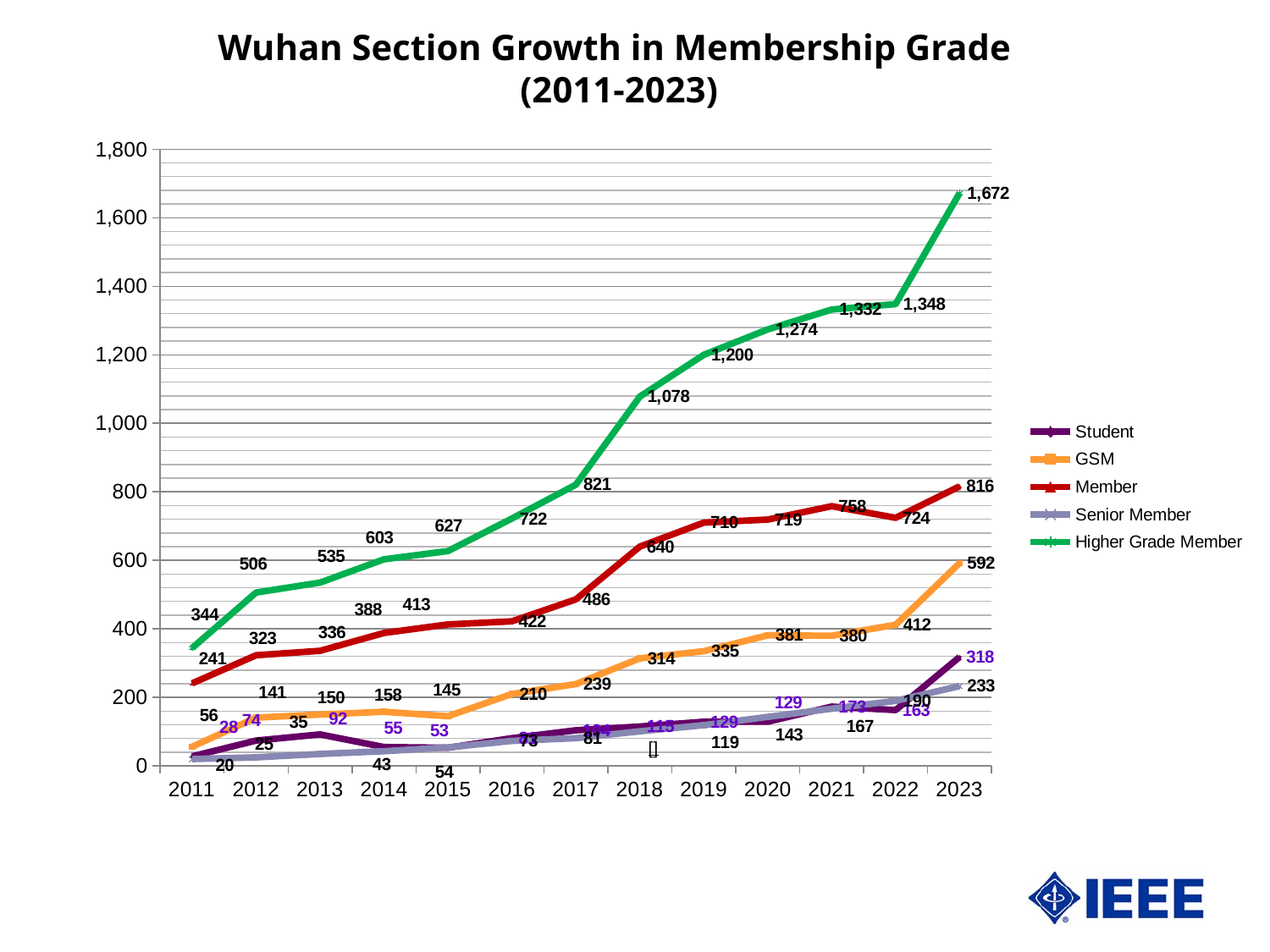
What is the value for GSM in 2023? 592 What is the value for Higher Grade Member in 2023? 1,672 What is the difference between the Higher Grade Member values in 2023 and 2022? 324 How many years are plotted on the x axis? 13 What is the value for Senior Member in 2023? 233 What type of chart is shown on the slide? line chart Does the Higher Grade Member series rise or fall from 2011 to 2023? rise In which year is the Member value lowest? 2011 What is the value for Member in 2018? 640 How many series does the legend list? 5 In which year is the Higher Grade Member value highest? 2023 Which is larger, the Member value in 2021 or the Member value in 2022? 2021